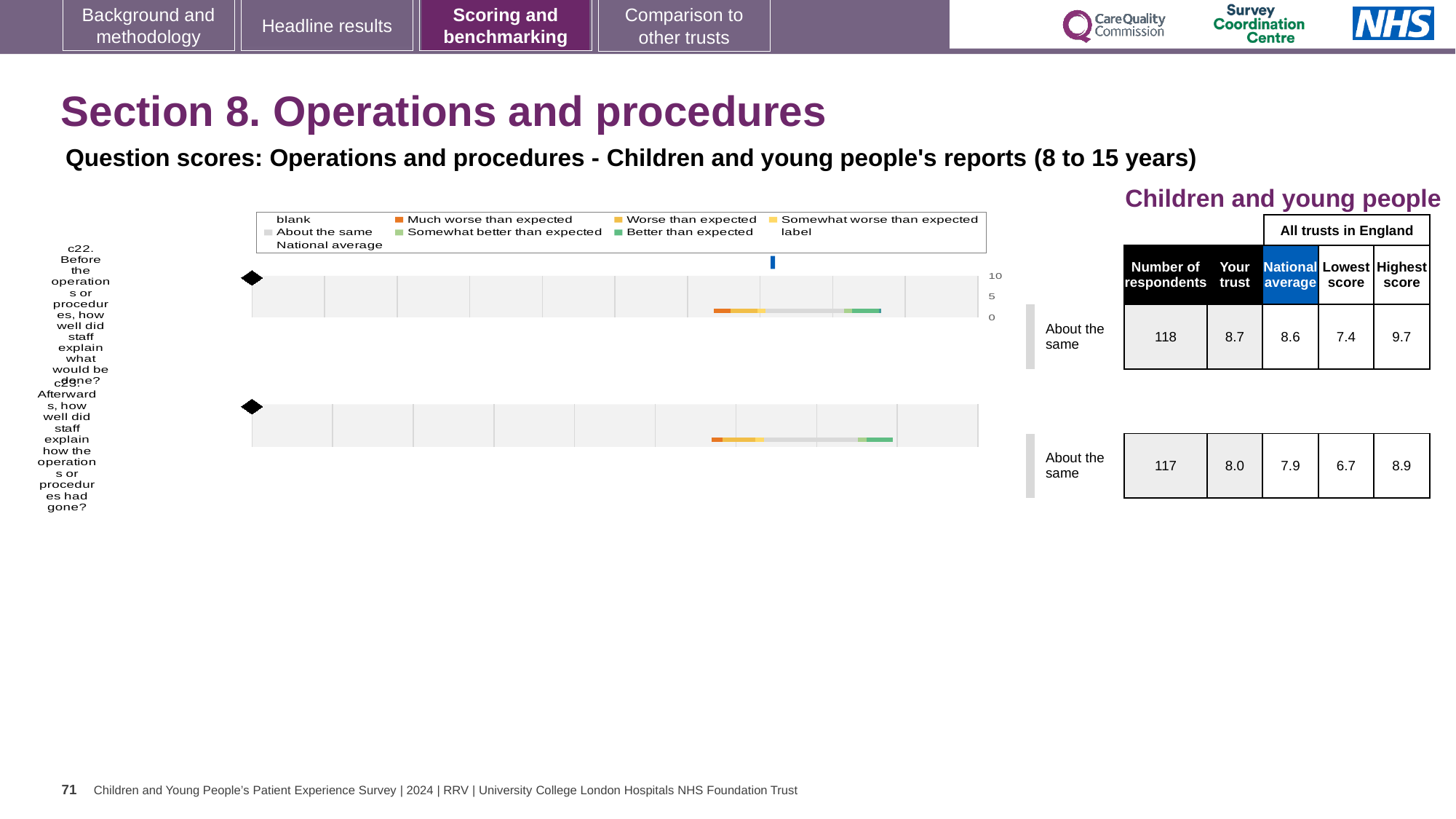
What is the 'Your trust' score for question c22? 8.7 In the chart legend, what colour represents 'Much worse than expected'? Orange What benchmark category is shown for question c22 (Before the operations or procedures, how well did staff explain what would be done?)? About the same What is the difference between the highest score (9.7) and the lowest score (7.4) for question c22? 2.3 What kind of chart is used to show the benchmarking results for questions c22 and c23? bar chart What is the national average score for question c23? 7.9 For question c22, which is larger: the 'Your trust' score or the national average? Your trust What is the highest score among all trusts in England for question c23? 8.9 How many survey questions are plotted on the slide? 2 How many respondents answered question c22? 118 What benchmark category is shown for question c23 (Afterwards, how well did staff explain how the operations or procedures had gone?)? About the same What is the difference between the 'Your trust' score and the national average for question c23? 0.1